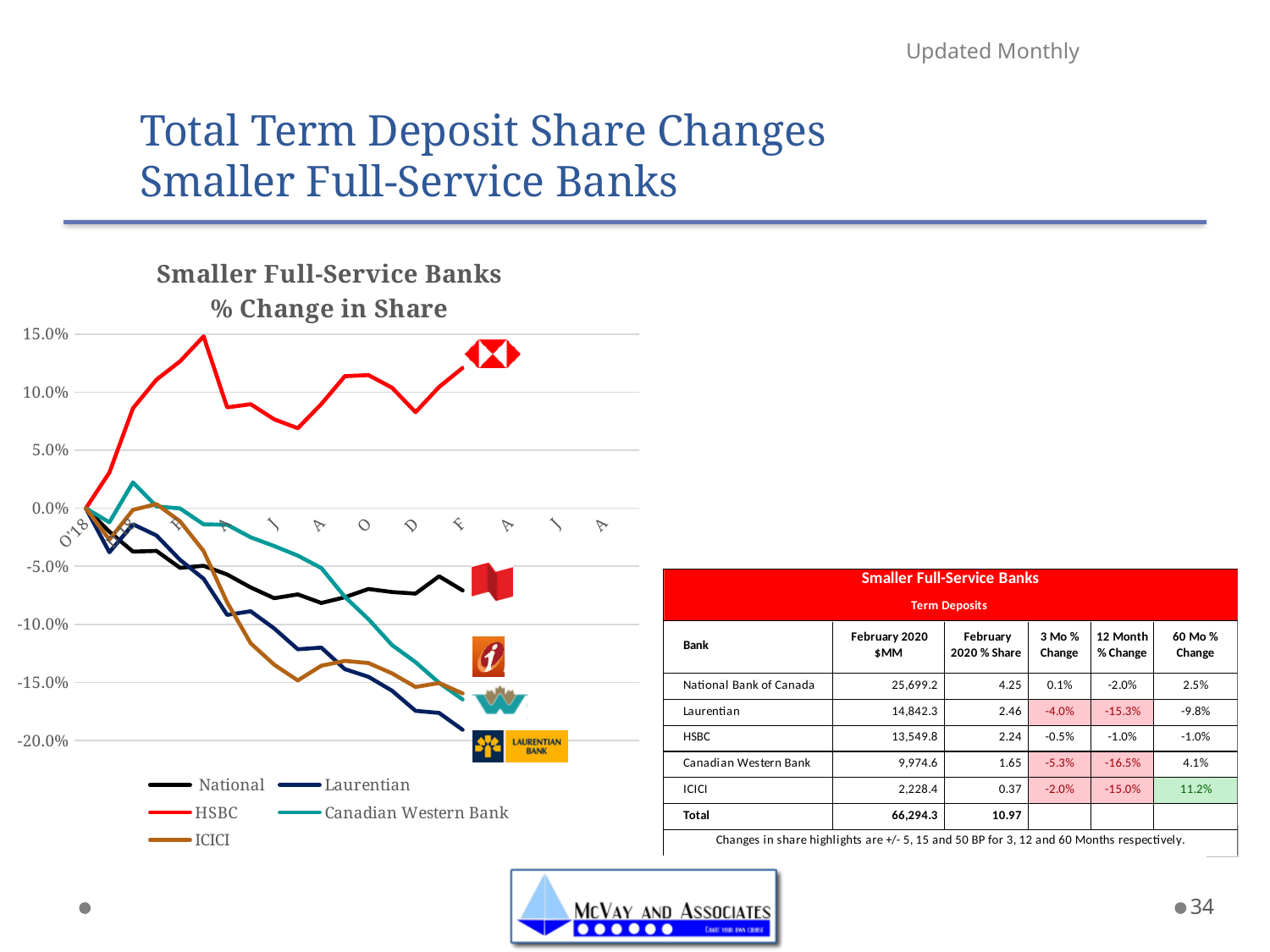
Does the Laurentian line generally rise or fall from left to right across the chart? fall What kind of chart is shown on the slide? line chart Which bank's line is lowest at the right end of the chart? Laurentian Is the final value of the ICICI line greater or less than -10.0%? less Which bank's line is highest at the right end of the chart? HSBC Is the final value of the Laurentian line greater or less than -15.0%? less What is the title of the chart? Smaller Full-Service Banks % Change in Share How many series does the legend of the chart list? 5 Is the final value of the HSBC line greater or less than 10.0%? greater At the right end of the chart, which line is higher: National or ICICI? National What colour is the HSBC line in the chart? red